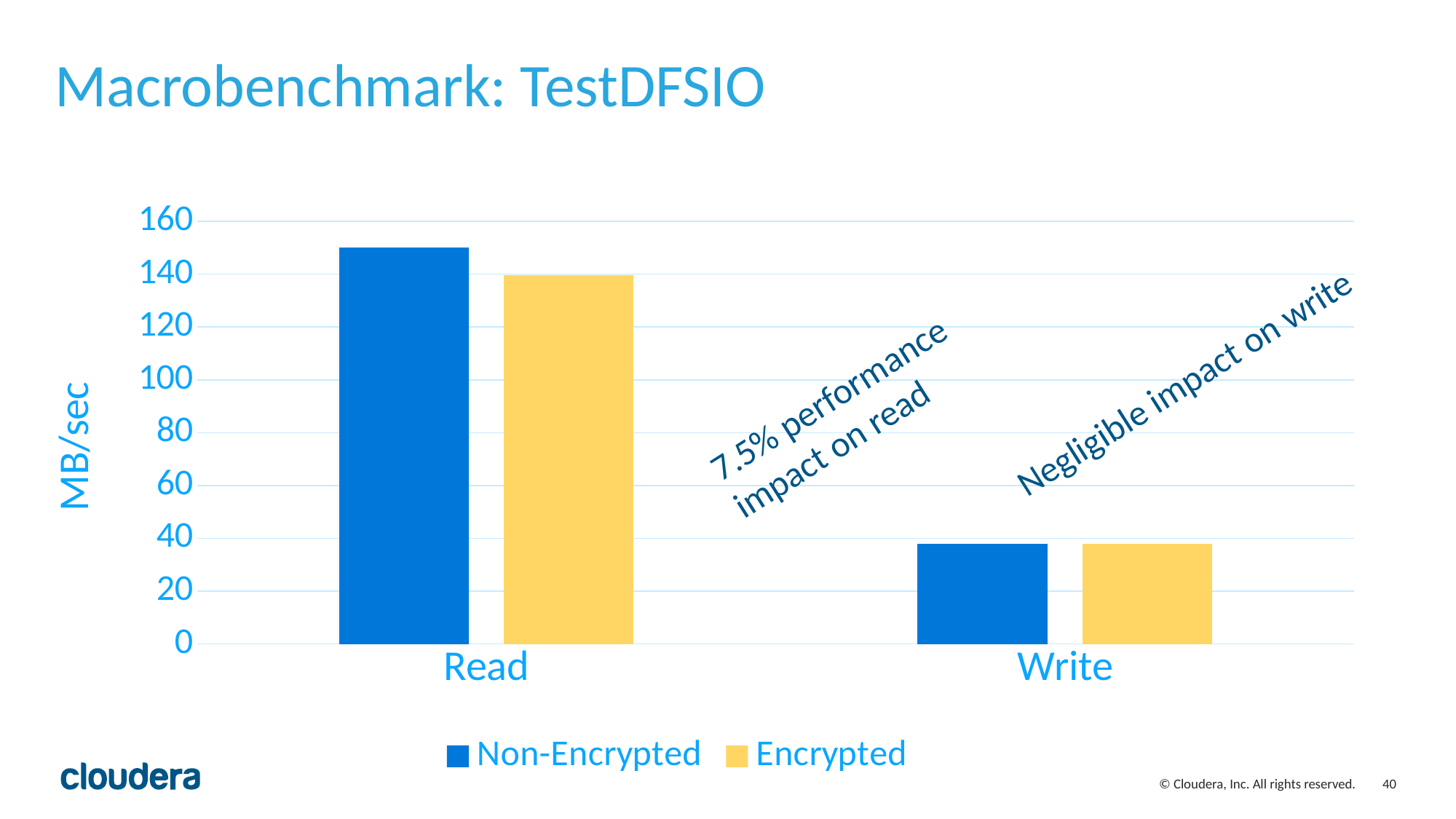
How many categories are shown on the x axis? 2 Is the Non-Encrypted value for Read greater or less than 140? greater Which category has the highest bar in the chart? Read What is the label on the y axis of the chart? MB/sec Is the Encrypted value for Read greater or less than 160? less Which category has the lower values, Read or Write? Write Is the Encrypted value for Write greater or less than 20? greater For Read, which is larger: Non-Encrypted or Encrypted? Non-Encrypted What kind of chart is shown on the slide? bar chart For the Non-Encrypted series, which is larger: Read or Write? Read How many series does the legend list? 2